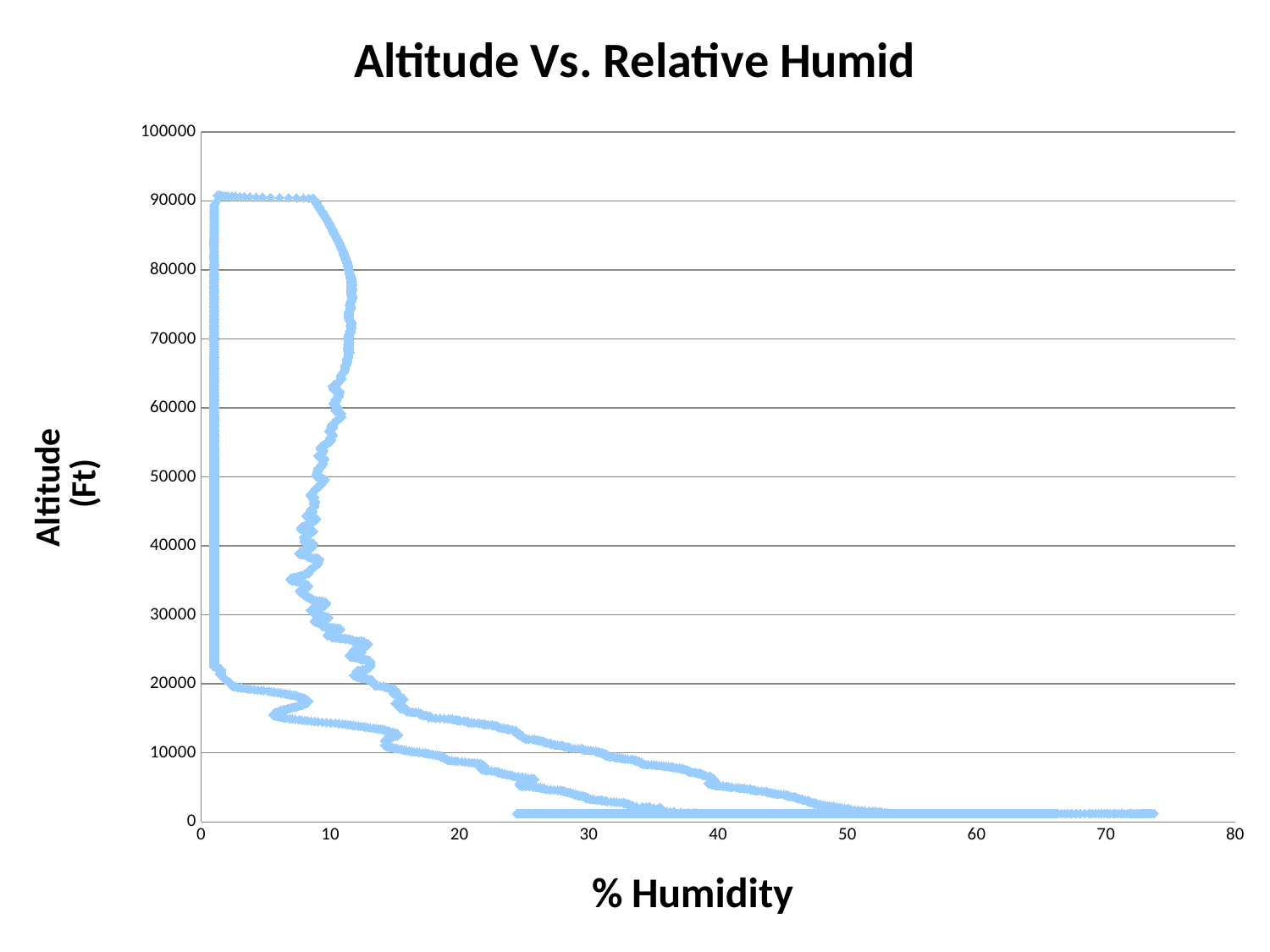
Is the maximum altitude reached by the plotted data greater or less than 80000 ft? greater Is the % Humidity at an altitude of 70000 ft greater or less than 30? less What kind of chart is shown on the slide? scatter chart Is the maximum % Humidity reached by the plotted data greater or less than 70? greater Is the highest % Humidity in the data found at low altitude or high altitude? low altitude As altitude increases from near the ground to 90000 ft, does % Humidity generally rise or fall? fall What is the highest value shown on the horizontal (% Humidity) axis? 80 What is the title of the chart? Altitude Vs. Relative Humid What is the highest value shown on the vertical (Altitude) axis? 100000 What is the label of the horizontal axis? % Humidity